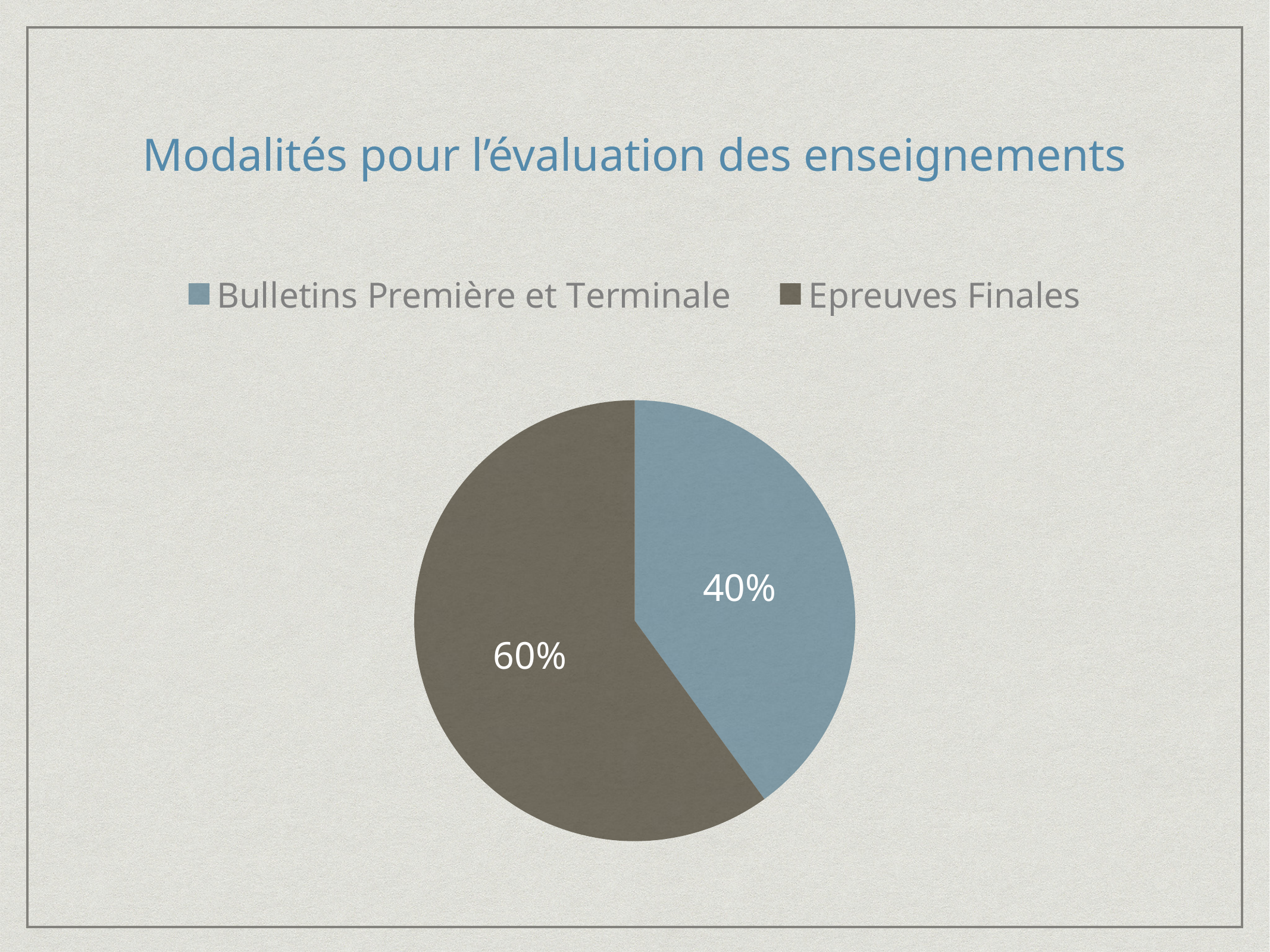
What is the difference between the Epreuves Finales share and the Bulletins Première et Terminale share? 20% Which colour represents Epreuves Finales in the chart? dark brown/grey How many entries does the legend list? 2 Which slice is the smallest? Bulletins Première et Terminale What is the title of the chart? Modalités pour l'évaluation des enseignements What share of the pie does Epreuves Finales represent? 60% How many slices does the pie chart have? 2 Which is larger, Bulletins Première et Terminale or Epreuves Finales? Epreuves Finales Which slice is the largest? Epreuves Finales What kind of chart is shown on the slide? pie chart What share of the pie does Bulletins Première et Terminale represent? 40%